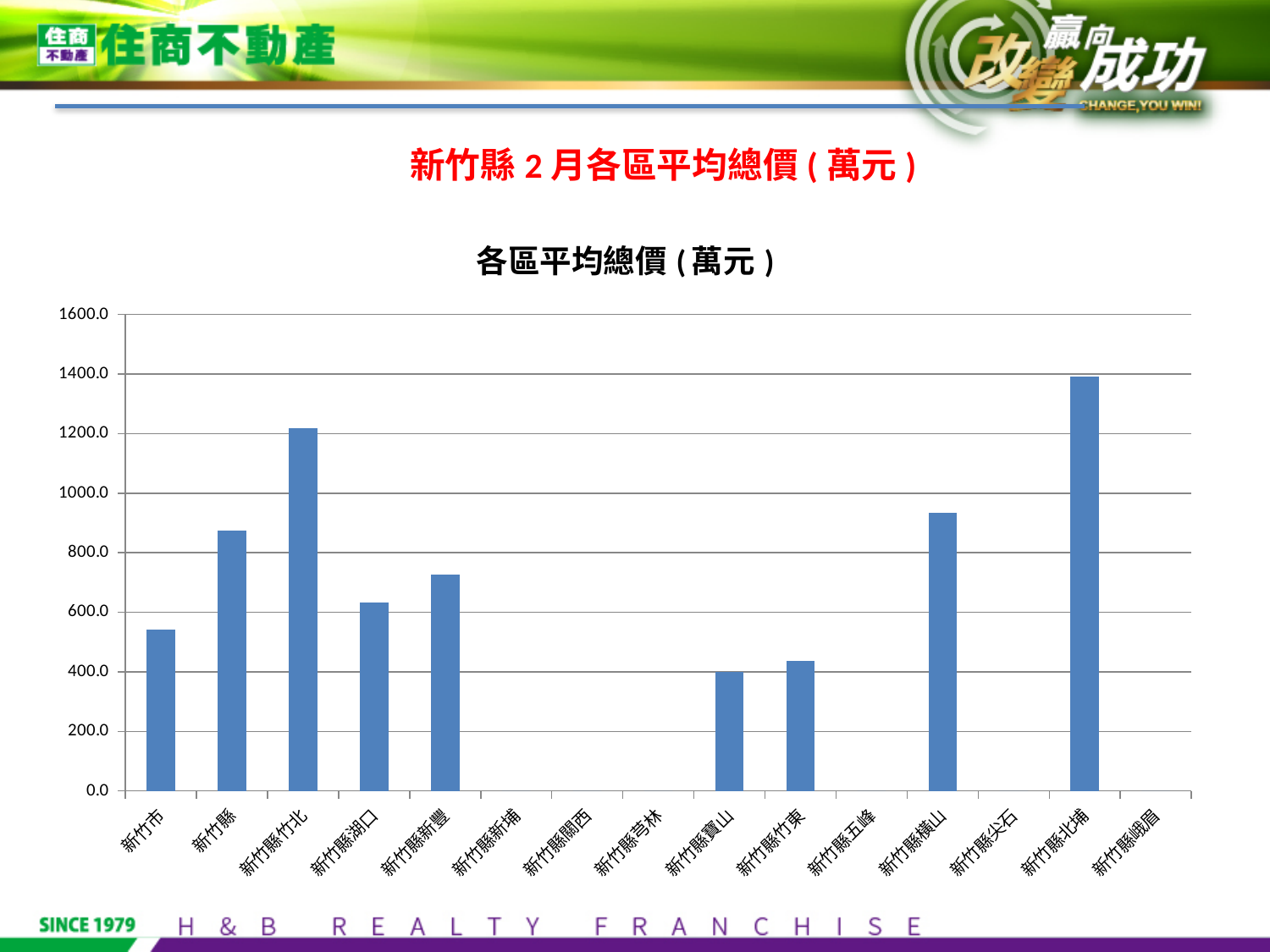
Is the value for 新竹市 greater or less than 400? greater Is the value for 新竹縣竹北 greater or less than 1000? greater Is the value for 新竹縣北埔 greater or less than 1200? greater What is the title of the chart? 各區平均總價 ( 萬元 ) Which is larger, the value for 新竹縣新豐 or the value for 新竹縣湖口? 新竹縣新豐 What kind of chart is shown on the slide? bar chart Which is larger, the value for 新竹縣竹北 or the value for 新竹縣橫山? 新竹縣竹北 Which category has the highest average total price in the chart? 新竹縣北埔 How many categories are shown on the x axis of the chart? 15 What is the highest value shown on the y axis of the chart? 1600.0